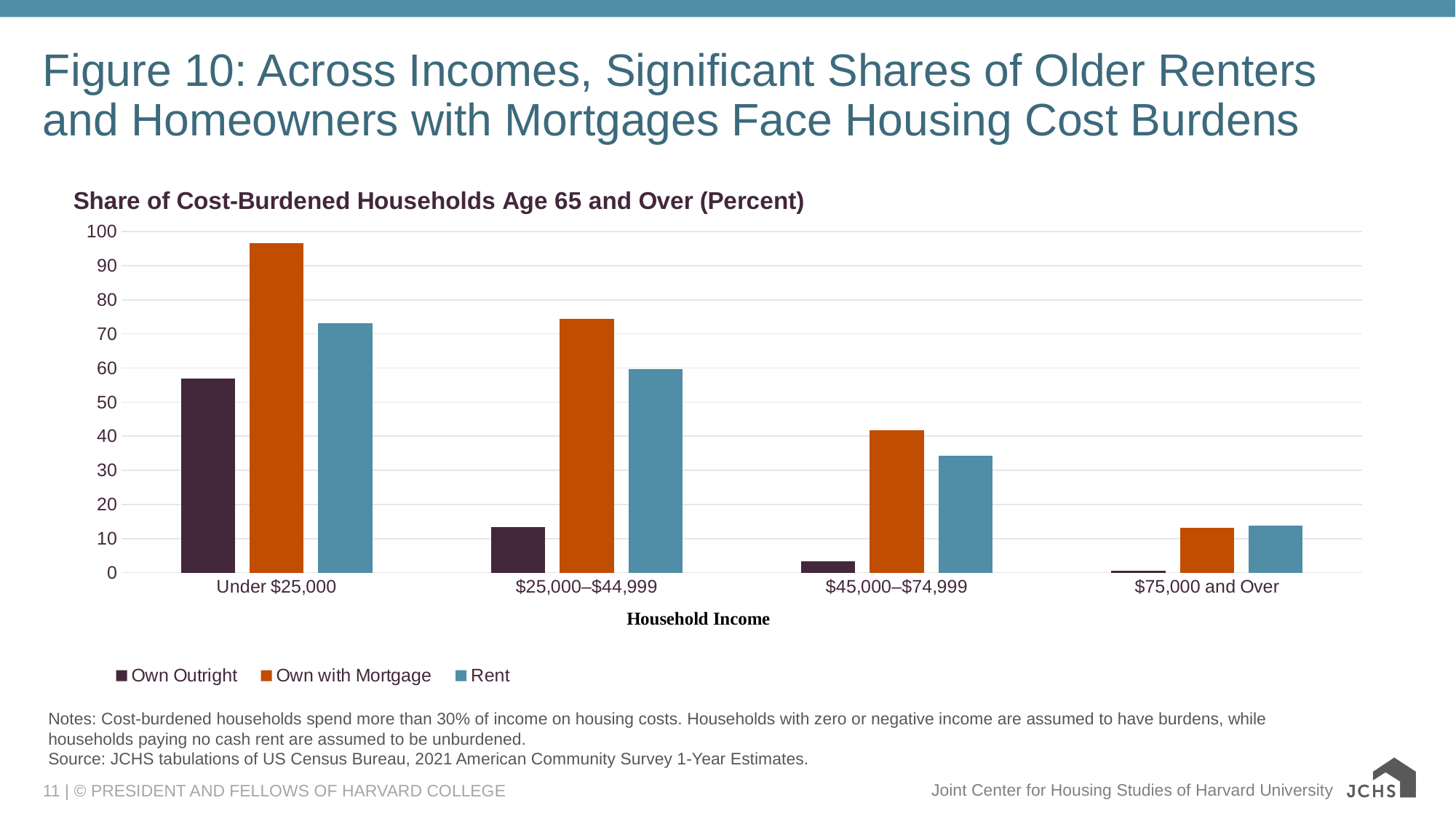
Is the Own Outright value for $25,000–$44,999 greater or less than 20? less Is the Rent value for $45,000–$74,999 greater or less than 30? greater For the $25,000–$44,999 category, which is larger: Own with Mortgage or Rent? Own with Mortgage Is the Own with Mortgage value for Under $25,000 greater or less than 90? greater How many series does the legend list? 3 What is the title of the x axis? Household Income Which income category has the lowest Own Outright value? $75,000 and Over Do the Own with Mortgage values rise or fall as household income increases along the x axis? fall For the Under $25,000 category, which is larger: Own Outright or Rent? Rent How many household income categories are shown on the x axis? 4 What kind of chart is shown on the slide? bar chart Which income category has the highest Own with Mortgage value? Under $25,000